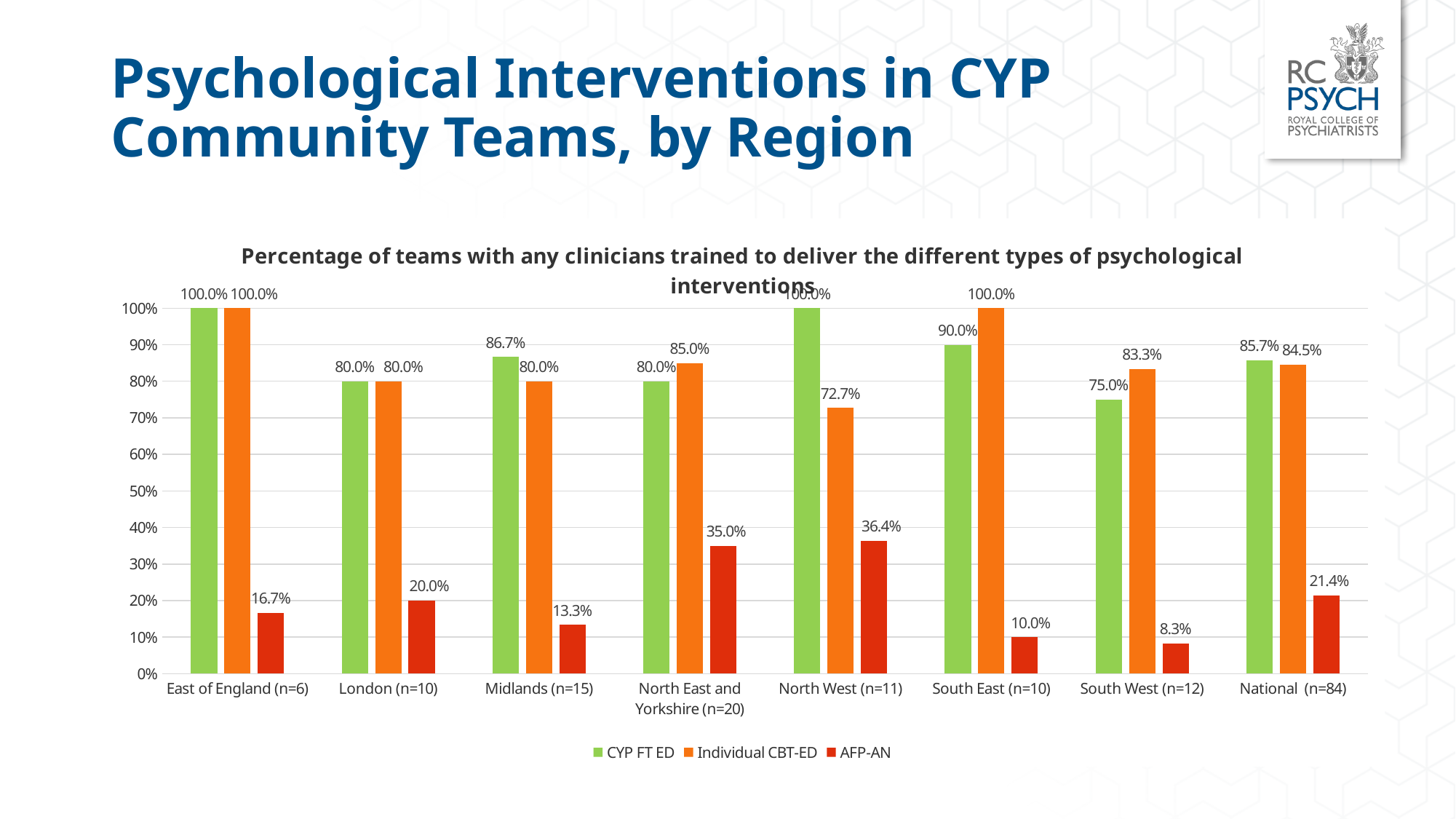
Which is larger for South West (n=12): the CYP FT ED value or the Individual CBT-ED value? Individual CBT-ED How many series does the legend list? 3 What is the AFP-AN value for North West (n=11)? 36.4% What is the Individual CBT-ED value for South West (n=12)? 83.3% What is the difference between the Individual CBT-ED values for South East (n=10) and North West (n=11)? 27.3% How many regions (categories) are shown on the x axis? 8 What is the National (n=84) value for Individual CBT-ED? 84.5% Which region has the lowest AFP-AN value? South West (n=12) Which region has the lowest Individual CBT-ED value? North West (n=11) What is the difference between the CYP FT ED and AFP-AN values for London (n=10)? 60.0% What type of chart is shown on the slide? Bar chart What is the CYP FT ED value for Midlands (n=15)? 86.7%